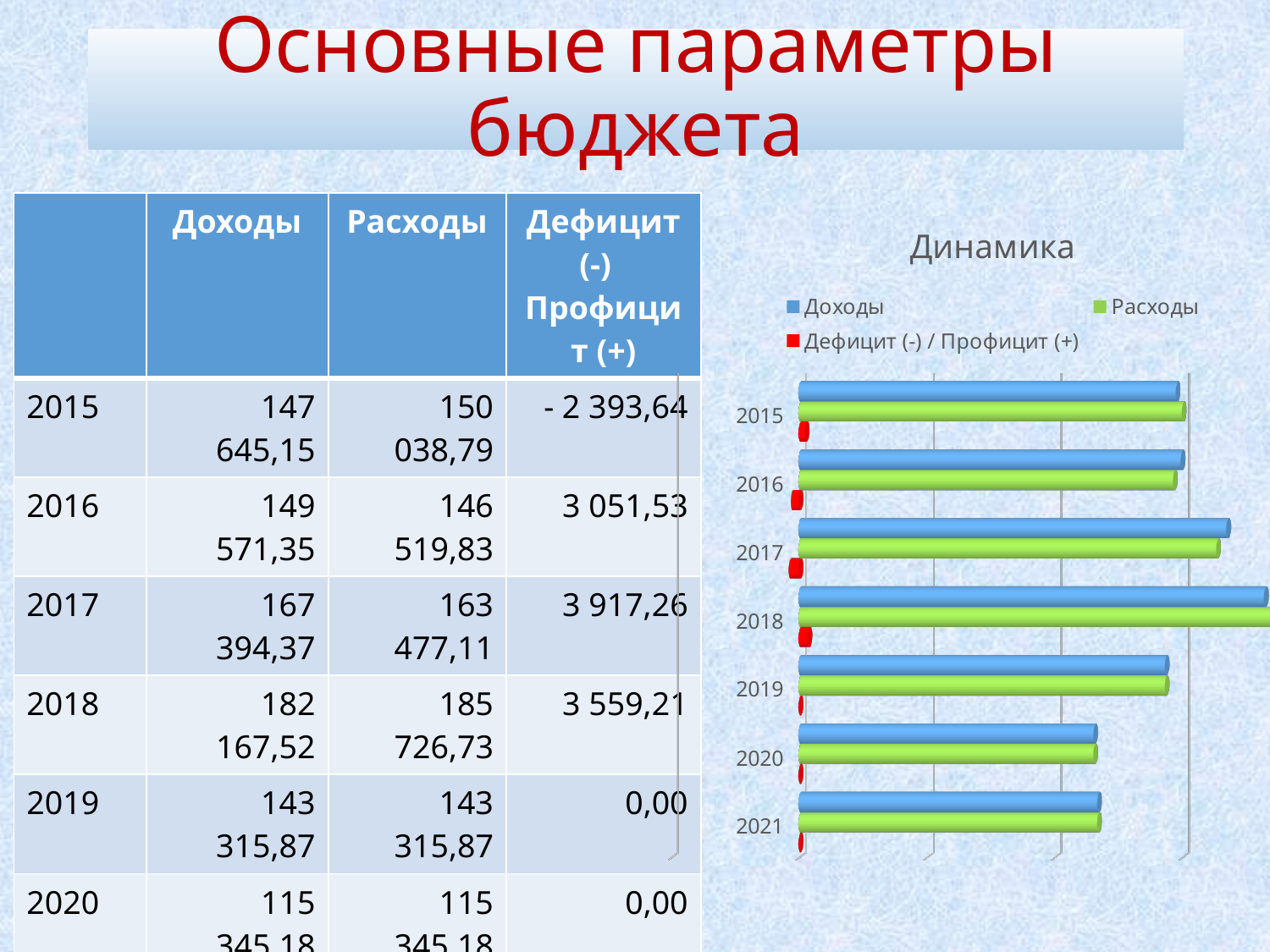
In the 'Динамика' chart, is the Доходы value for 2017 larger or smaller than the Доходы value for 2019? larger What type of chart is the 'Динамика' chart? bar chart In the 'Динамика' chart, which year has the lowest value for Расходы? 2020 How many years are shown on the 'Динамика' chart? 7 In the 'Динамика' chart, which year has the highest value for Доходы? 2018 In the 'Динамика' chart, do the Доходы values rise or fall from 2018 to 2020? fall How many series does the legend of the 'Динамика' chart list? 3 In the 'Динамика' chart, which year has the highest value for Расходы? 2018 In the 'Динамика' chart, which colour represents the Расходы series? green In the 'Динамика' chart, which year has the lowest value for Доходы? 2020 In the 'Динамика' chart, which is larger for 2018: Доходы or Расходы? Расходы What is the title of the chart on the slide? Динамика